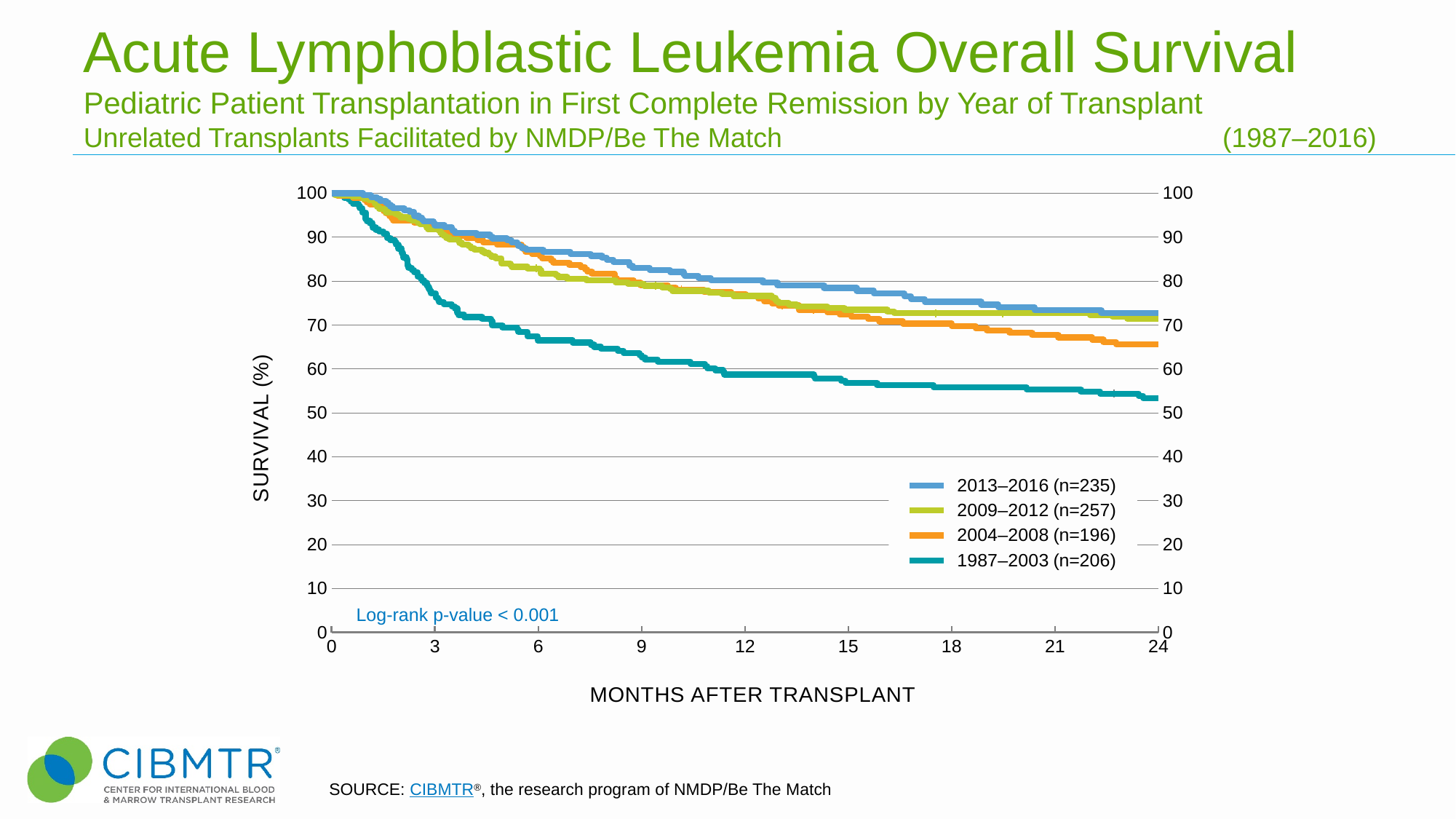
According to the legend, how many patients (n) are in the 2004–2008 group? 196 What is the title of the chart on the slide? Acute Lymphoblastic Leukemia Overall Survival How many series does the legend list? 4 Which series has the lowest survival at 24 months after transplant? 1987–2003 (n=206) Do the survival values rise or fall as months after transplant increase? fall What is the survival value for the 2013–2016 series at 0 months after transplant? 100 Is the survival value for the 2004–2008 series at 24 months greater or less than 70? less Is the survival value for the 2013–2016 series at 24 months greater or less than 70? greater Which series has the highest survival at 24 months after transplant? 2013–2016 (n=235) Is the survival value for the 1987–2003 series at 24 months greater or less than 60? less At 12 months after transplant, which series has higher survival: 2013–2016 or 1987–2003? 2013–2016 What kind of chart is shown on the slide? line chart